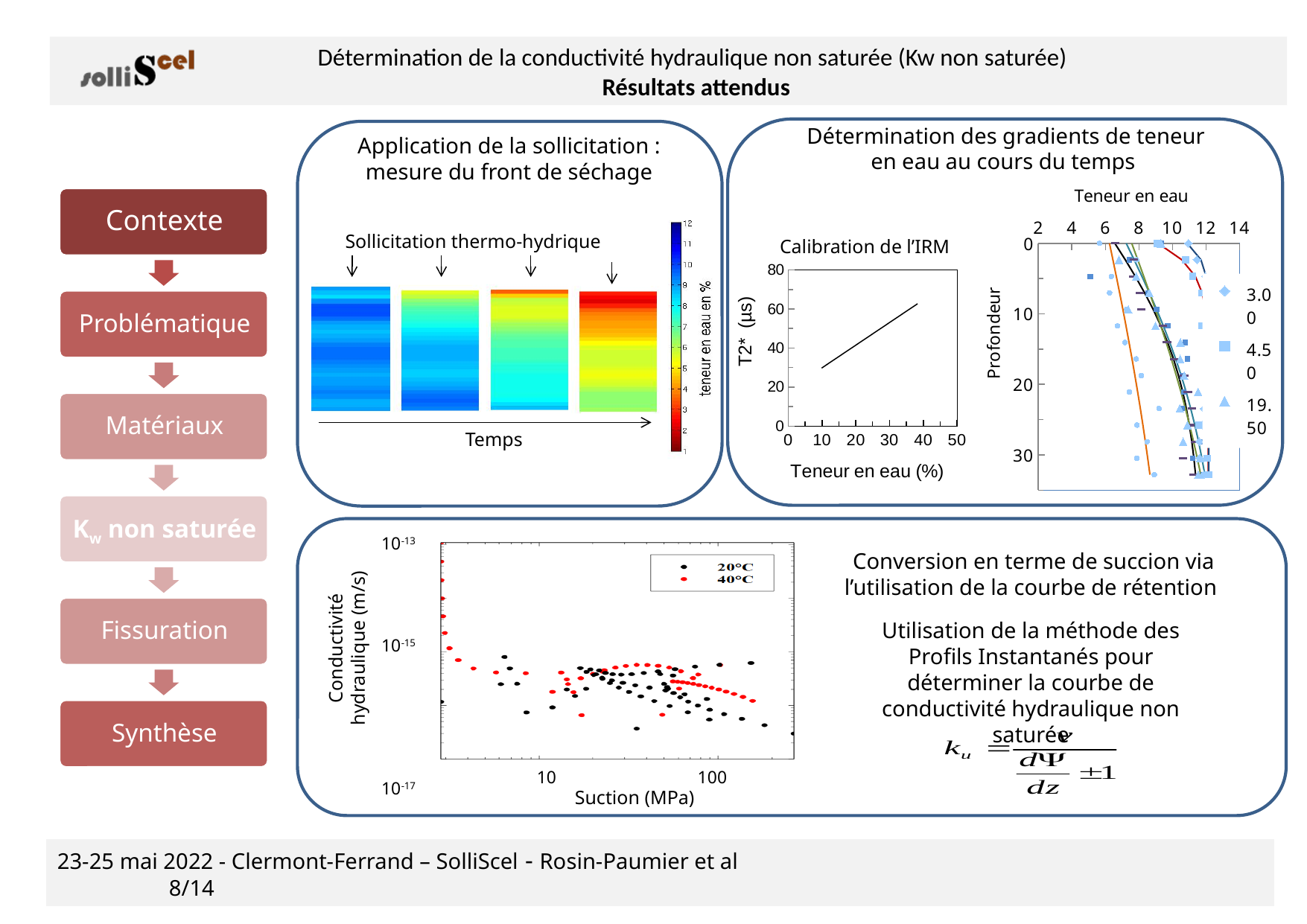
What kind of chart is the 'Calibration de l'IRM' chart? line chart How many legend entries are shown beside the 'Teneur en eau' profile chart? 3 What kind of chart is the bottom chart of conductivité hydraulique versus suction? scatter chart In the bottom conductivité hydraulique chart, which series is plotted in red? 40°C In the 'Calibration de l'IRM' chart, does T2* rise or fall as teneur en eau increases? rises In the 'Calibration de l'IRM' chart, is the T2* value at 10% teneur en eau greater or less than 40? less What is the maximum value shown on the Profondeur axis of the 'Teneur en eau' profile chart? 30 In the 'Calibration de l'IRM' chart, is the T2* value at 30% teneur en eau greater or less than 40? greater How many series does the legend of the bottom conductivité hydraulique chart list? 2 What is the maximum value shown on the x axis of the 'Calibration de l'IRM' chart? 50 In the bottom conductivité hydraulique chart, is the 40°C conductivity at the lowest suction greater or less than 10^-15 m/s? greater What is the x-axis label of the bottom conductivité hydraulique chart? Suction (MPa)